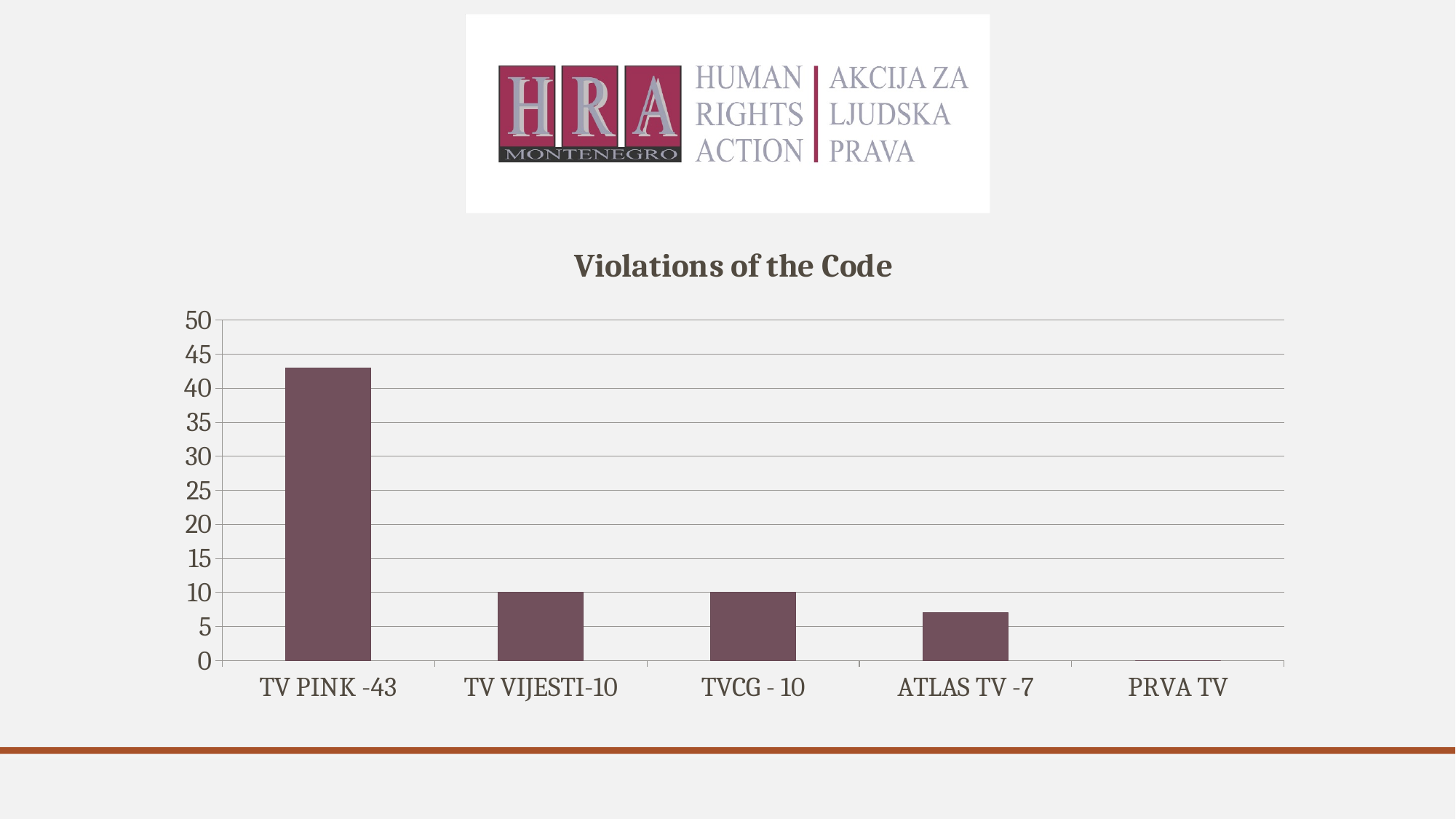
What is the value for ATLAS TV? 7 What is the value for TV VIJESTI? 10 Is the value for PRVA TV greater or less than 5? less What kind of chart is shown on the slide? bar chart What is the difference between the values for TV VIJESTI and ATLAS TV? 3 What is the title of the chart? Violations of the Code How many categories are shown on the x axis? 5 What is the difference between the values for TV PINK and TVCG? 33 Which is larger, the value for TVCG or the value for ATLAS TV? TVCG Which category has the highest value? TV PINK What is the value for TV PINK? 43 Which category has the lowest value? PRVA TV